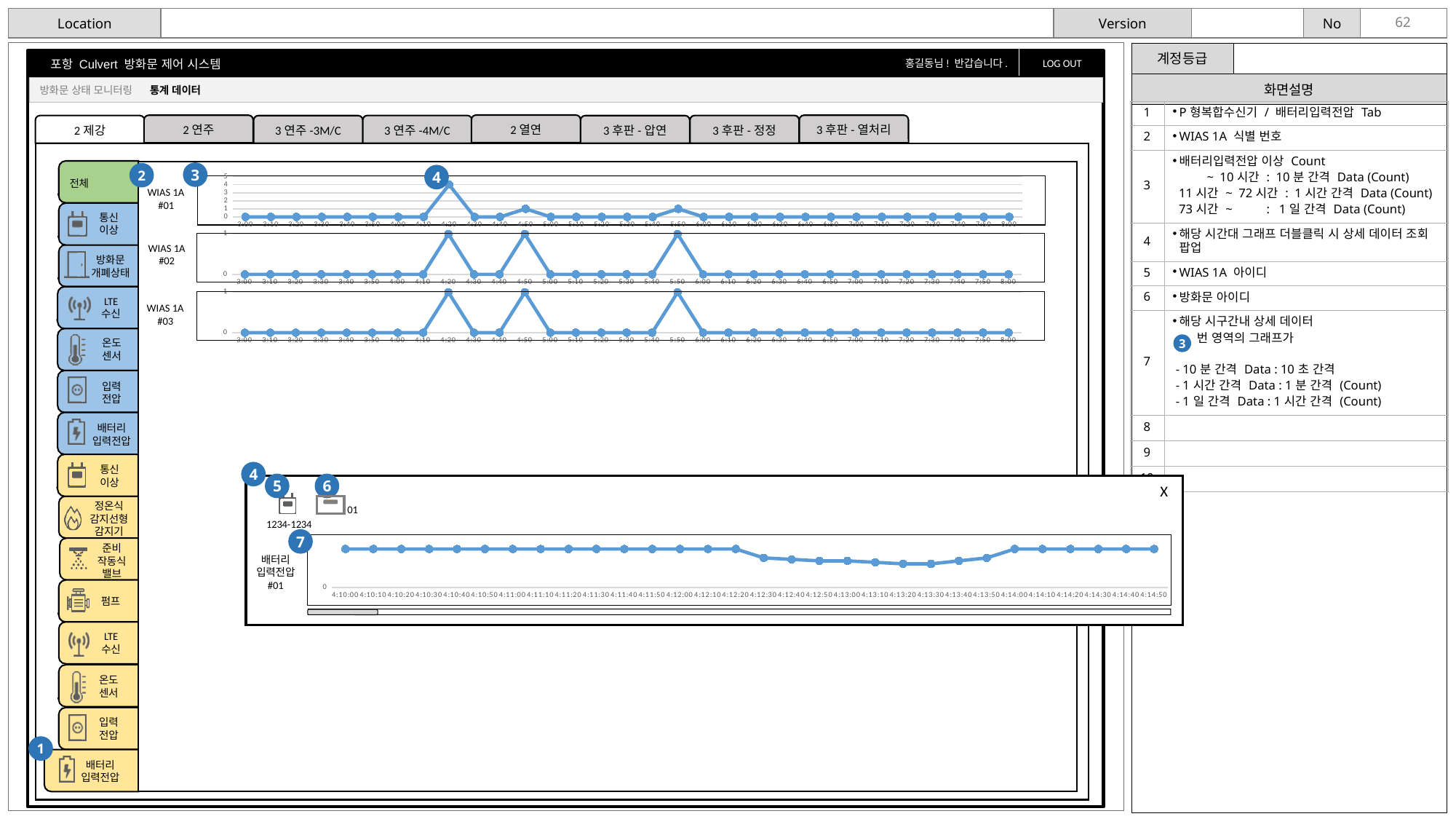
In the 배터리 입력전압 #01 chart in the popup, does the line rise or fall between 4:12:20 and 4:13:00? fall What kind of chart is used for WIAS 1A #01? line chart In the WIAS 1A #02 chart, what is the value at 4:20? 1 In the WIAS 1A #02 chart, what is the value at 3:00? 0 In the WIAS 1A #01 chart, which is larger, the value at 4:20 or the value at 4:50? 4:20 In the WIAS 1A #03 chart, how many times does the line rise to 1? 3 In the WIAS 1A #03 chart, what is the value at 5:50? 1 How many line charts are shown on the slide in total? 4 What is the first time label on the x axis of the 배터리 입력전압 #01 chart in the popup? 4:10:00 In the WIAS 1A #01 chart, is the value at 4:20 greater or less than 3? greater In the WIAS 1A #01 chart, what is the value at 3:00? 0 In the WIAS 1A #01 chart, at which time does the line reach its highest point? 4:20